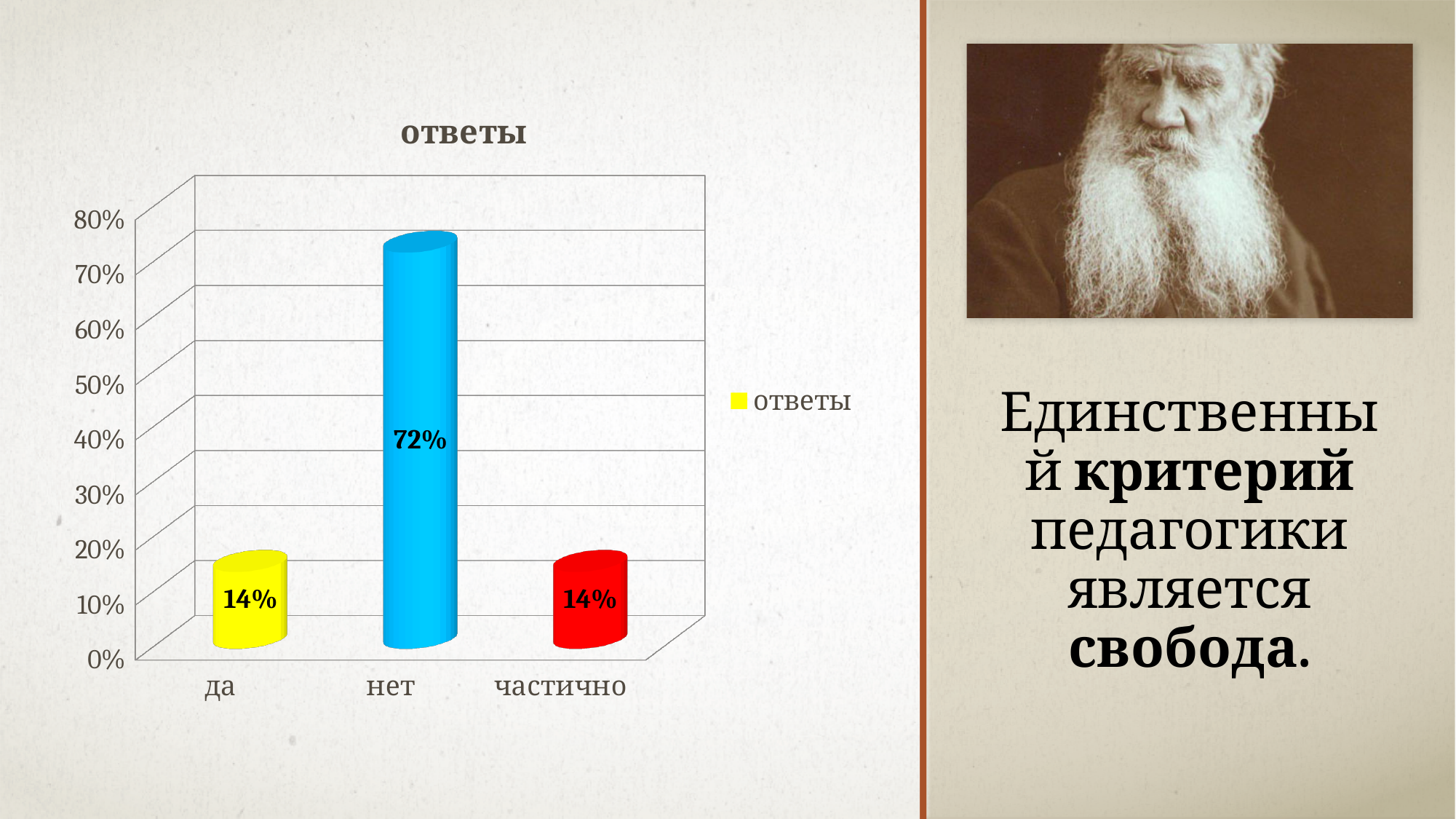
What is the value for "частично"? 14% What is the value for "да"? 14% Which category has the highest value? нет Which is larger, the value for "нет" or the value for "частично"? нет How many series does the legend list? 1 Is the value for "нет" greater or less than 50%? greater What is the title of the chart? ответы Is the value for "да" greater or less than 20%? less How many categories are shown on the x axis? 3 What is the difference between the values for "нет" and "да"? 58% What is the value for "нет"? 72% What kind of chart is shown on the slide? bar chart